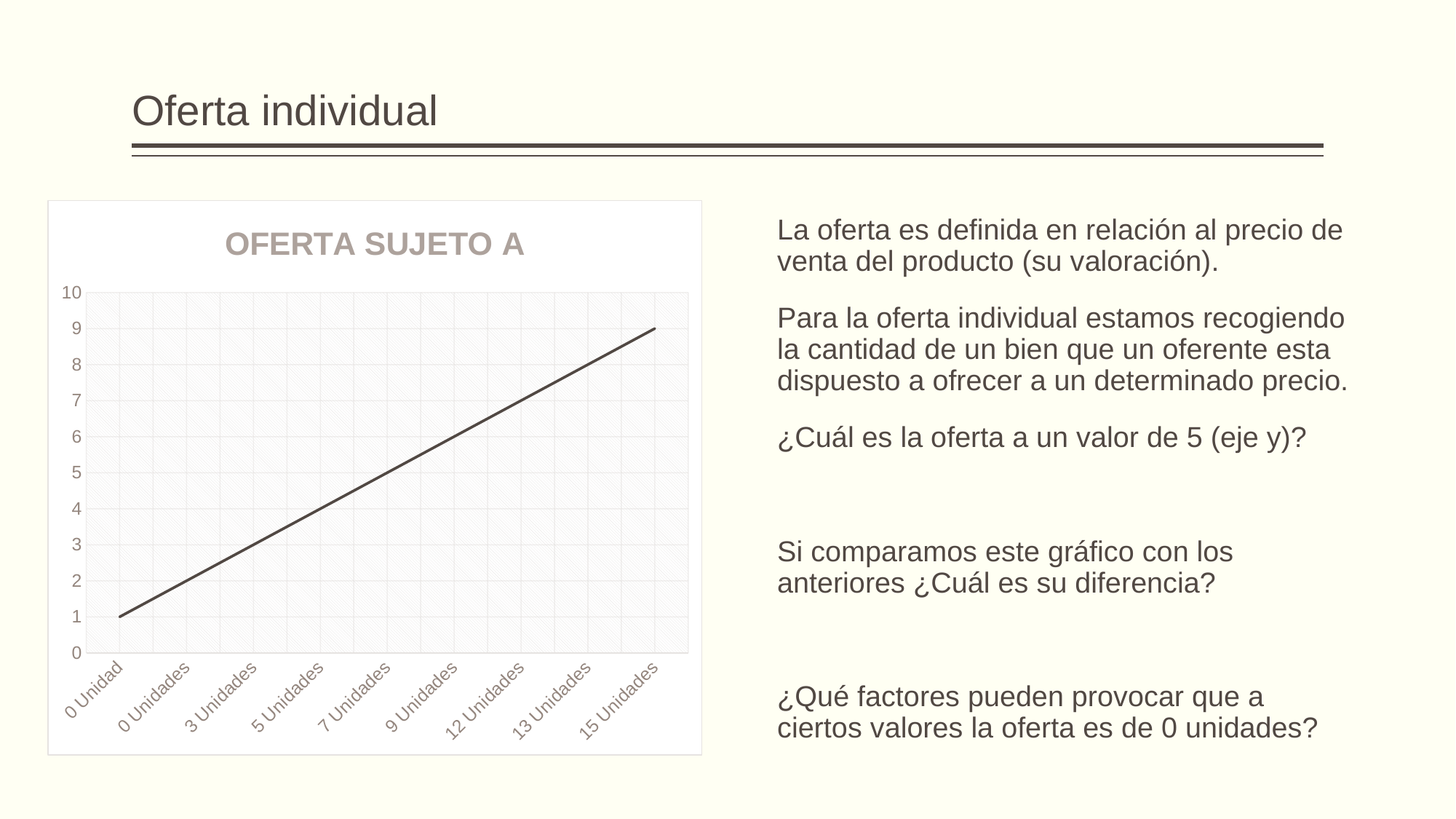
How many categories are shown on the x axis of the chart? 9 What kind of chart is shown on the slide? Line chart What is the difference between the values for "15 Unidades" and "0 Unidad"? 8 What is the title of the chart? OFERTA SUJETO A What is the value for "7 Unidades"? 5 What is the value for "15 Unidades"? 9 Which category has the highest value? 15 Unidades Is the value for "13 Unidades" greater or less than 5? greater Which is larger, the value for "12 Unidades" or the value for "3 Unidades"? 12 Unidades Do the values rise or fall along the x axis from "0 Unidad" to "15 Unidades"? Rise What is the value for "0 Unidad"? 1 Which category has the lowest value? 0 Unidad